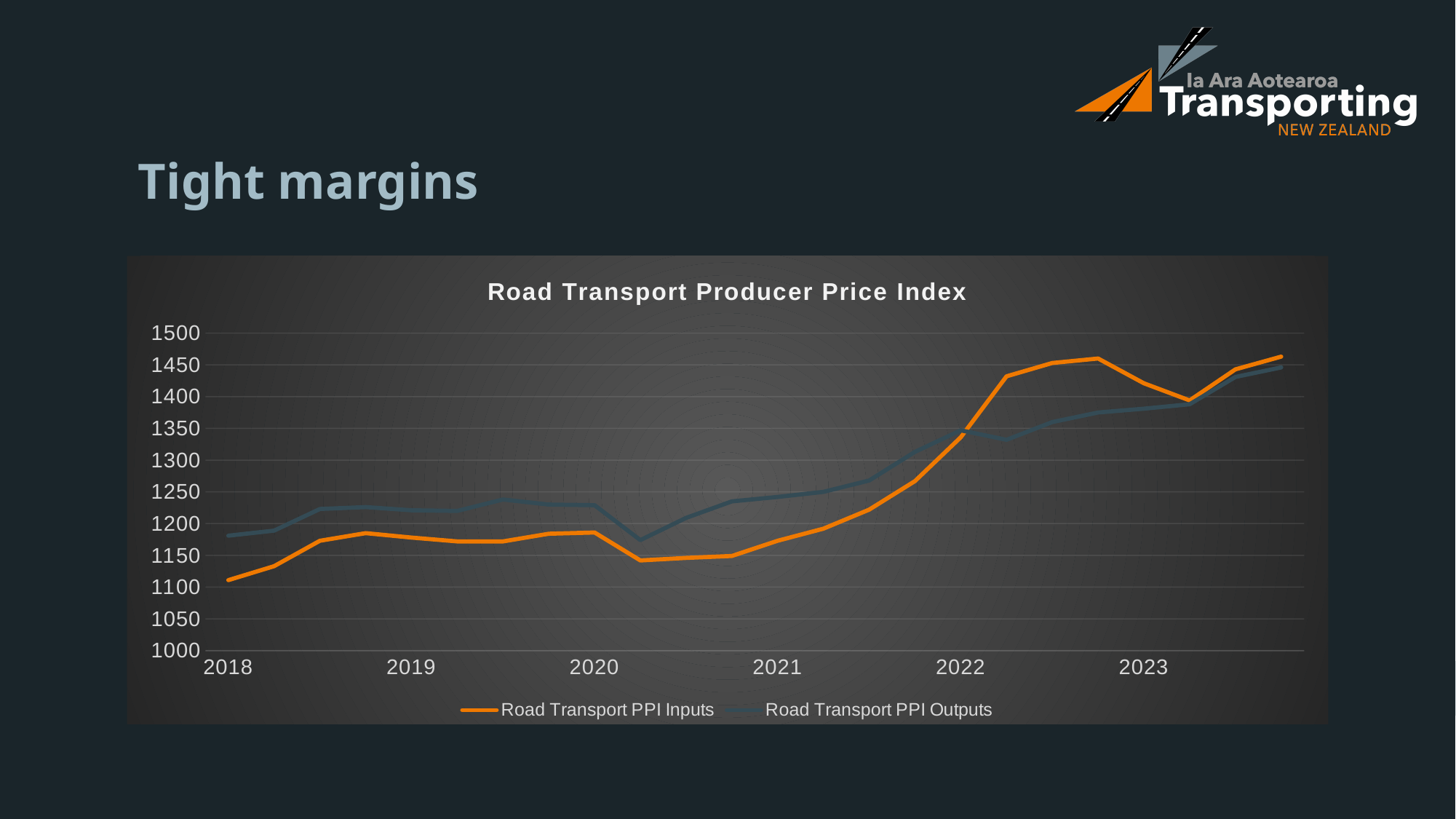
Is the value for Road Transport PPI Inputs at 2023 greater or less than 1400? greater How many series does the legend list? 2 Is the value for Road Transport PPI Outputs at 2023 greater or less than 1400? less Is the value for Road Transport PPI Inputs at 2018 greater or less than 1150? less How many year labels are shown on the x axis? 6 What kind of chart is shown on the slide? line chart Overall, do the Road Transport PPI Inputs values rise or fall from 2018 to 2023? rise Which series is drawn in orange? Road Transport PPI Inputs At 2020, which series has the higher value, Road Transport PPI Inputs or Road Transport PPI Outputs? Road Transport PPI Outputs At 2023, which series has the higher value, Road Transport PPI Inputs or Road Transport PPI Outputs? Road Transport PPI Inputs What is the title of the chart? Road Transport Producer Price Index